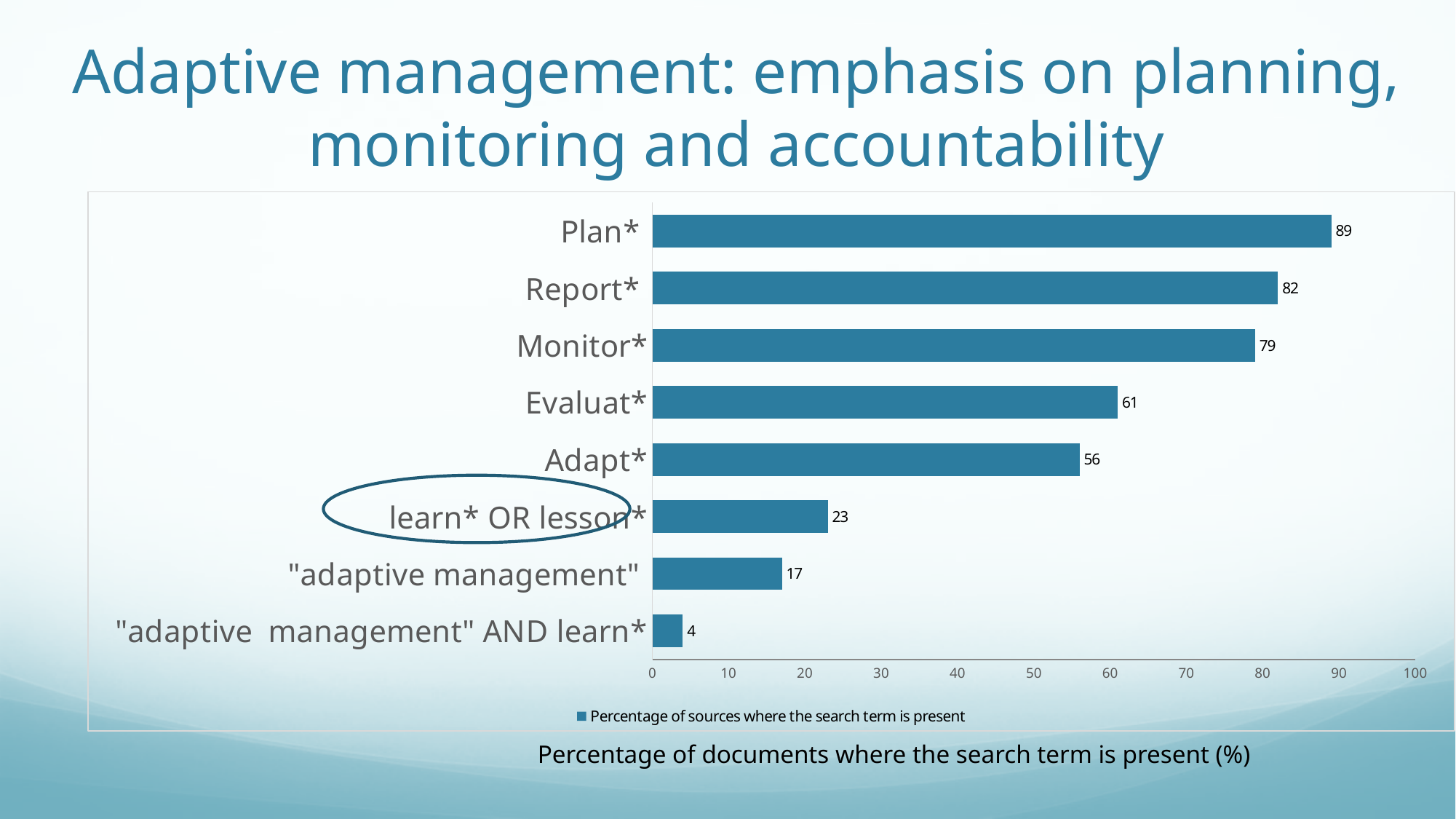
What is the value for learn* OR lesson*? 23 What is the difference between the values for Evaluat* and Adapt*? 5 Which category has the lowest value? "adaptive management" AND learn* Which is larger, the value for Monitor* or the value for Evaluat*? Monitor* What kind of chart is shown on the slide? bar chart What is the legend entry for the series shown in the chart? Percentage of sources where the search term is present Is the value for Adapt* greater or less than 50? greater What is the value for "adaptive management"? 17 What is the value for Plan*? 89 Which category has the highest value? Plan* What is the difference between the values for Report* and Monitor*? 3 How many categories are shown in the chart? 8